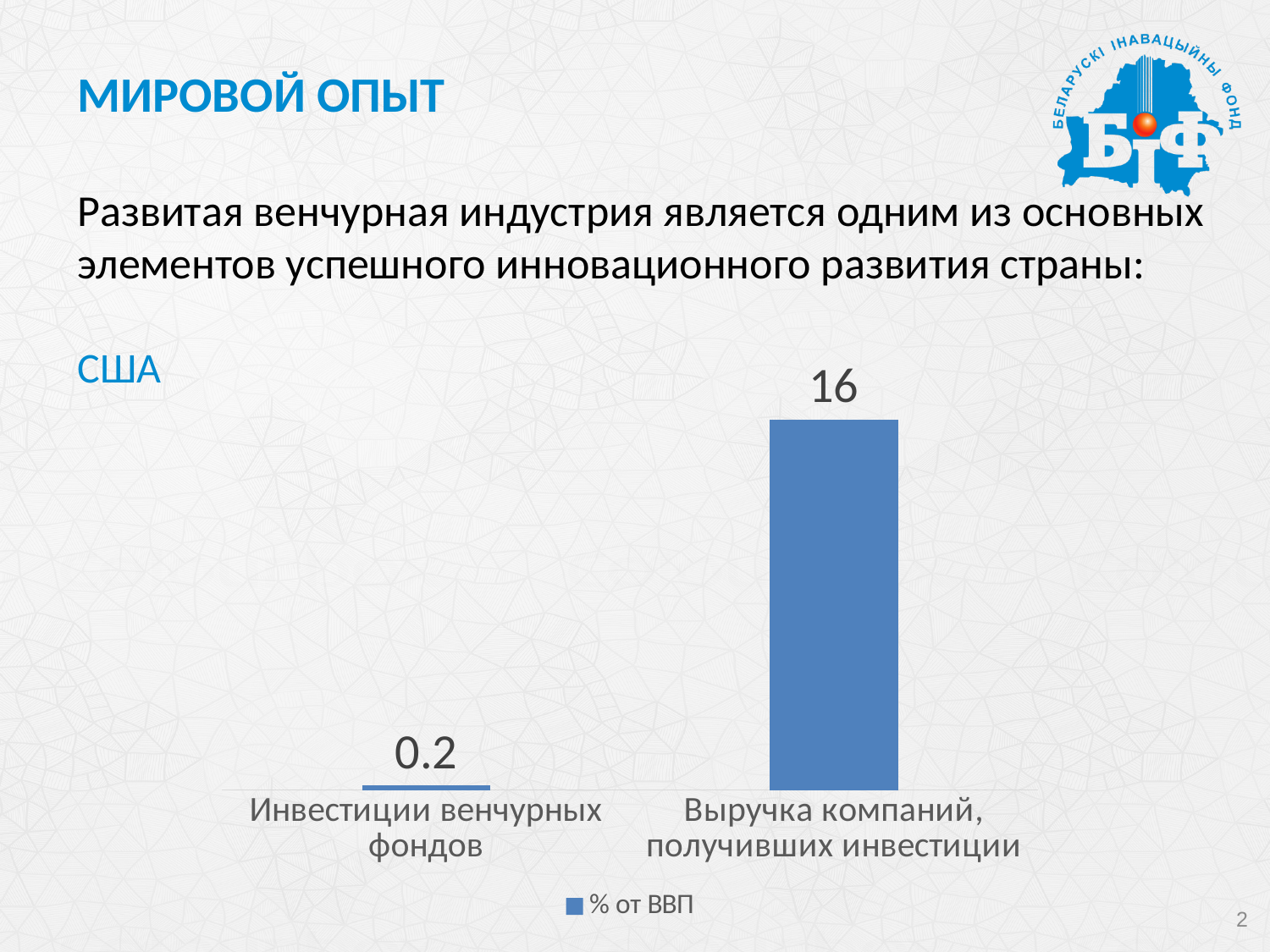
What kind of chart is shown on the slide? bar chart What is the legend entry of the series shown in the chart? % от ВВП What is the difference between the values for "Выручка компаний, получивших инвестиции" and "Инвестиции венчурных фондов"? 15.8 Do the values rise or fall from left to right along the x axis? rise How many series does the legend list? 1 Which country does the chart refer to, according to the label above it? США What is the value for "Инвестиции венчурных фондов"? 0.2 What is the value for "Выручка компаний, получивших инвестиции"? 16 How many categories are shown in the chart? 2 Which is larger: the value for "Инвестиции венчурных фондов" or for "Выручка компаний, получивших инвестиции"? Выручка компаний, получивших инвестиции Which category has the highest value? Выручка компаний, получивших инвестиции Which category has the lowest value? Инвестиции венчурных фондов